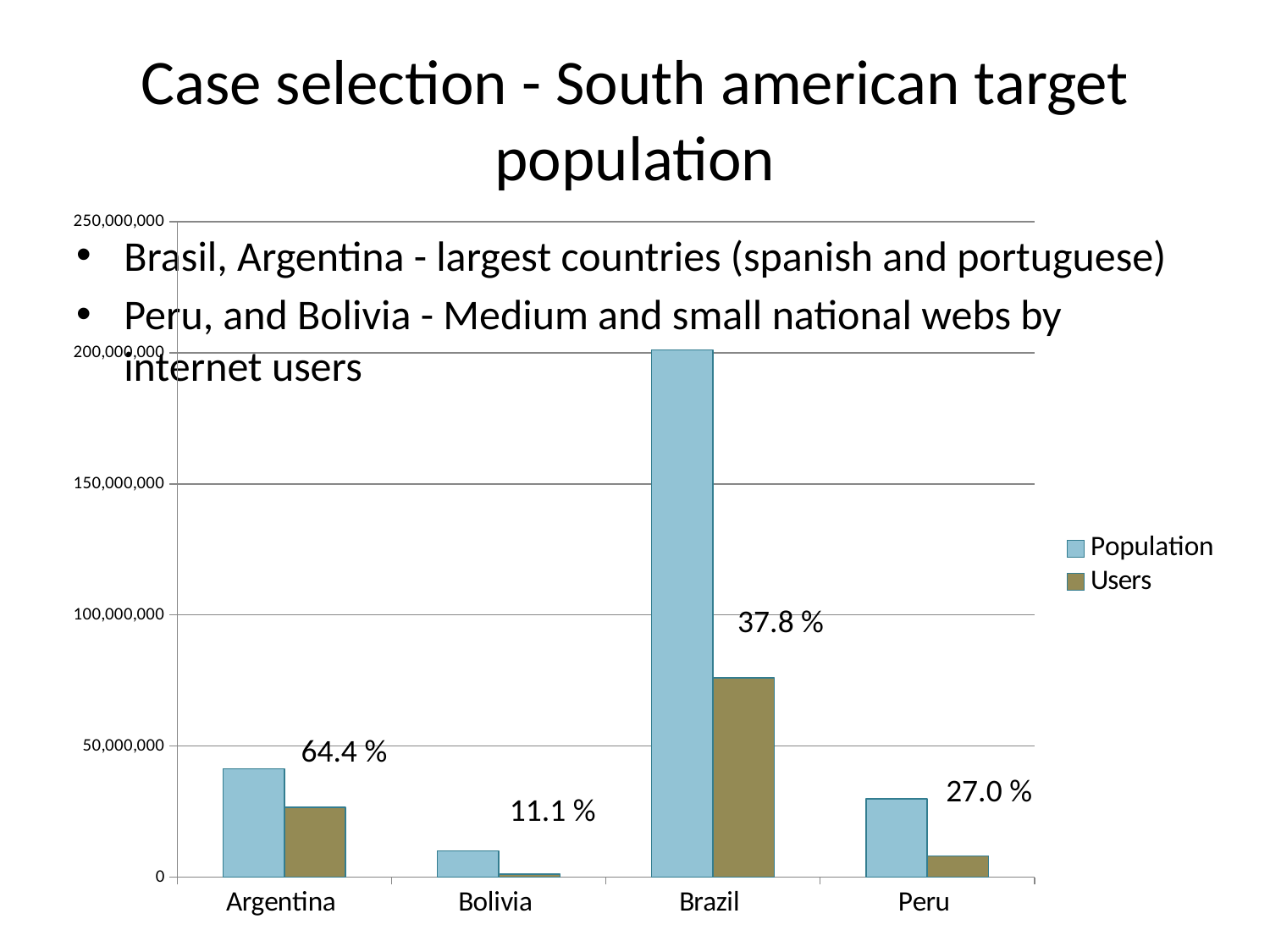
Is the Population value for Argentina greater or less than 50,000,000? less What kind of chart is shown on the slide? bar chart Which country has the highest Users bar? Brazil How many countries are shown on the x axis of the chart? 4 What percentage label is printed above the bars for Argentina? 64.4 % Which country has the lowest Population bar? Bolivia How many series does the chart's legend list? 2 Is the Population value for Brazil greater or less than 150,000,000? greater Which country has the lowest Users bar? Bolivia Which country has the larger Population bar, Argentina or Peru? Argentina Which country has the highest Population bar? Brazil What are the two series named in the chart's legend? Population and Users